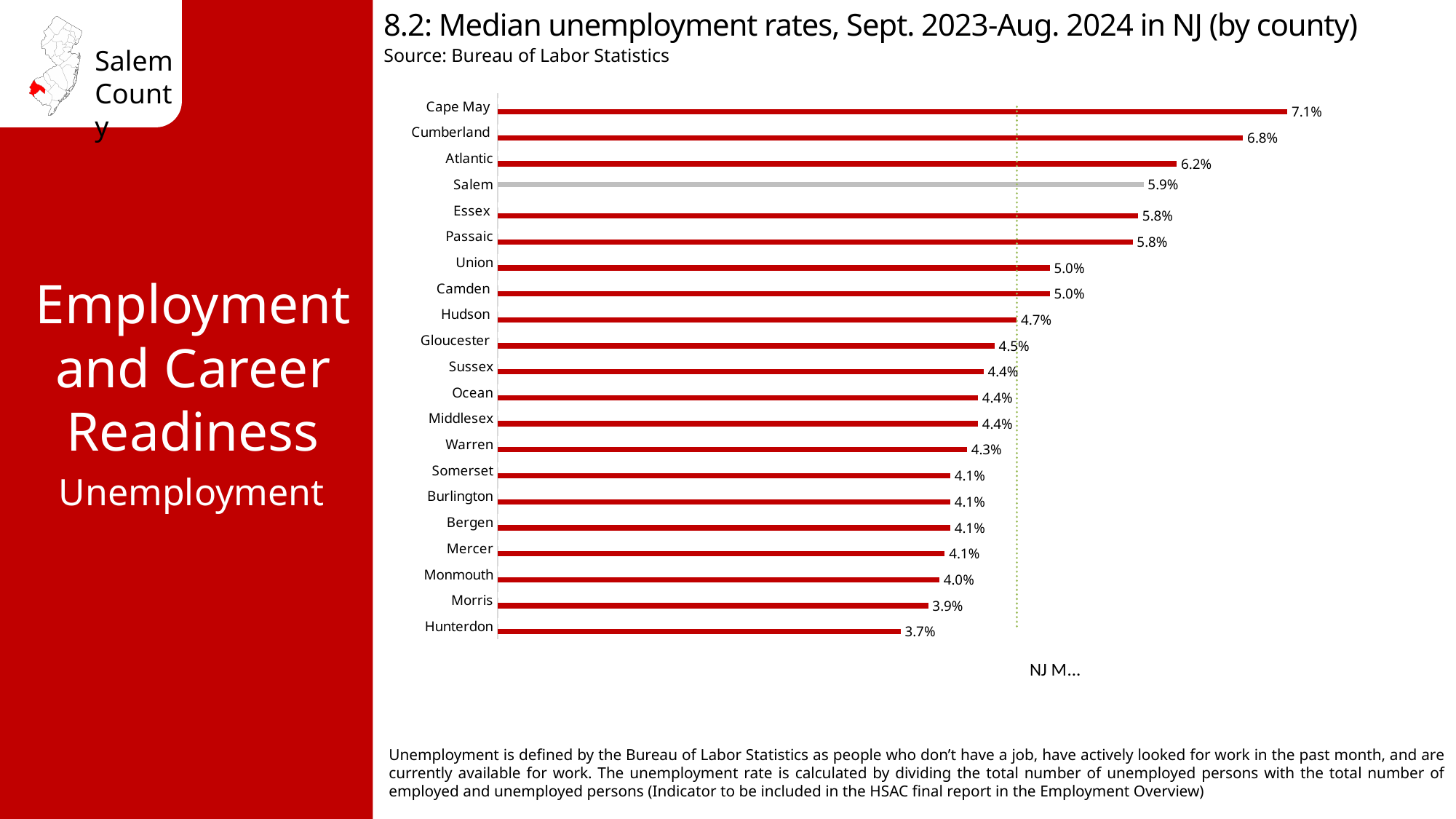
What kind of chart is shown on the slide? Bar chart What is the difference between the median unemployment rates of Cape May and Hunterdon? 3.4% What is the difference between the median unemployment rates of Atlantic and Salem? 0.3% What is the median unemployment rate for Hudson county? 4.7% What is the median unemployment rate for Salem county? 5.9% What is the median unemployment rate for Cumberland county? 6.8% How many counties are shown in the chart? 21 Which county has a higher median unemployment rate, Gloucester or Warren? Gloucester Which county's bar is shown in grey rather than red? Salem Which county has the lowest median unemployment rate? Hunterdon What is the source cited for the chart? Bureau of Labor Statistics Which county has the highest median unemployment rate? Cape May